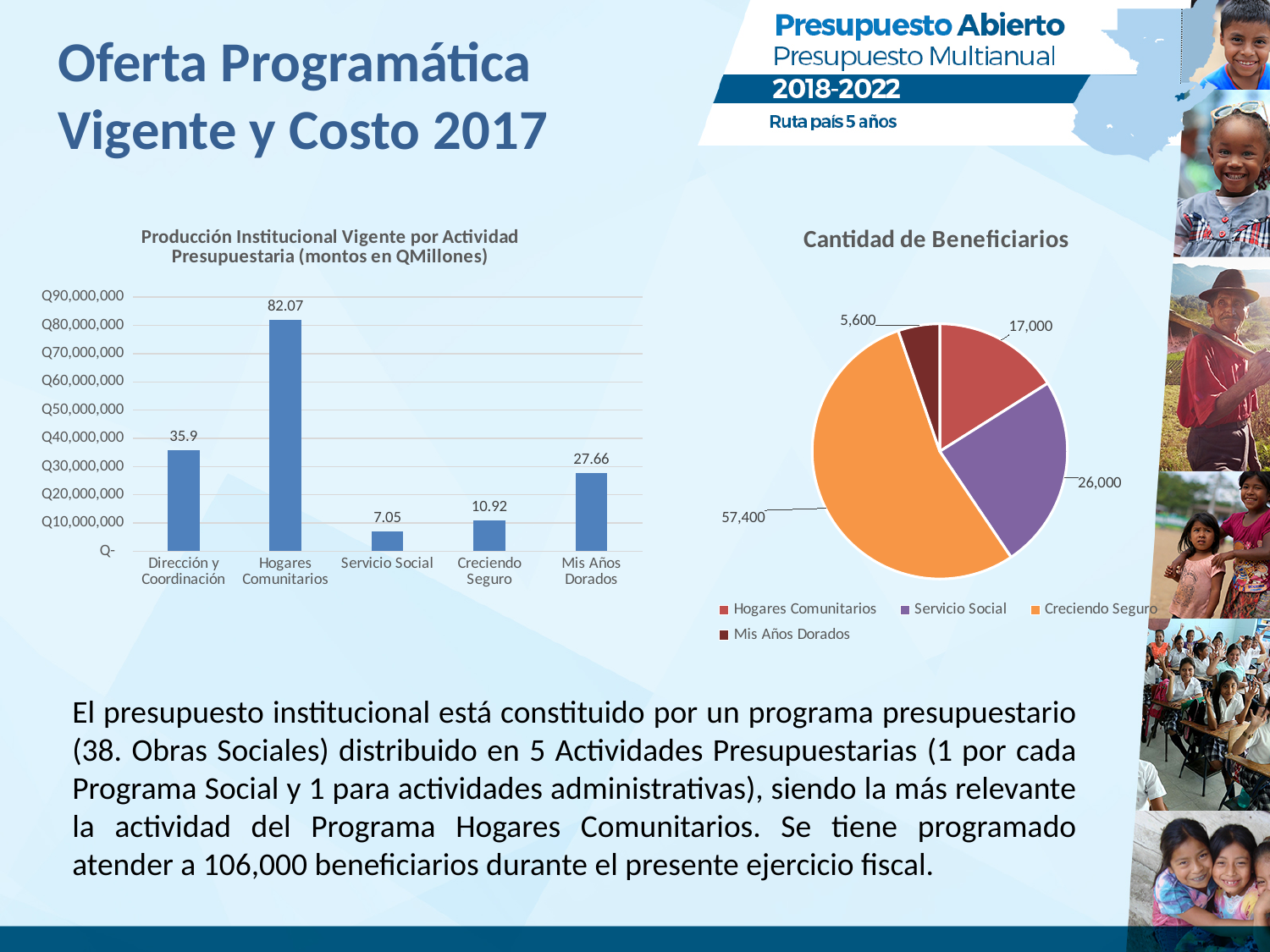
In the bar chart 'Producción Institucional Vigente por Actividad Presupuestaria', which activity has the lowest value? Servicio Social In the bar chart 'Producción Institucional Vigente por Actividad Presupuestaria', what is the value for Servicio Social? 7.05 In the bar chart 'Producción Institucional Vigente por Actividad Presupuestaria', which activity has the highest value? Hogares Comunitarios In the bar chart 'Producción Institucional Vigente por Actividad Presupuestaria', what is the value for Hogares Comunitarios? 82.07 In the pie chart 'Cantidad de Beneficiarios', what is the total of all slices? 106,000 In the pie chart 'Cantidad de Beneficiarios', what is the value for Creciendo Seguro? 57,400 In the bar chart 'Producción Institucional Vigente por Actividad Presupuestaria', how many activities are shown? 5 In the bar chart 'Producción Institucional Vigente por Actividad Presupuestaria', what is the difference between Dirección y Coordinación and Mis Años Dorados? 8.24 In the pie chart 'Cantidad de Beneficiarios', what is the value for Mis Años Dorados? 5,600 What kind of chart is 'Producción Institucional Vigente por Actividad Presupuestaria'? Bar chart In the pie chart 'Cantidad de Beneficiarios', how many categories does the legend list? 4 In the pie chart 'Cantidad de Beneficiarios', which is larger: Hogares Comunitarios or Servicio Social? Servicio Social